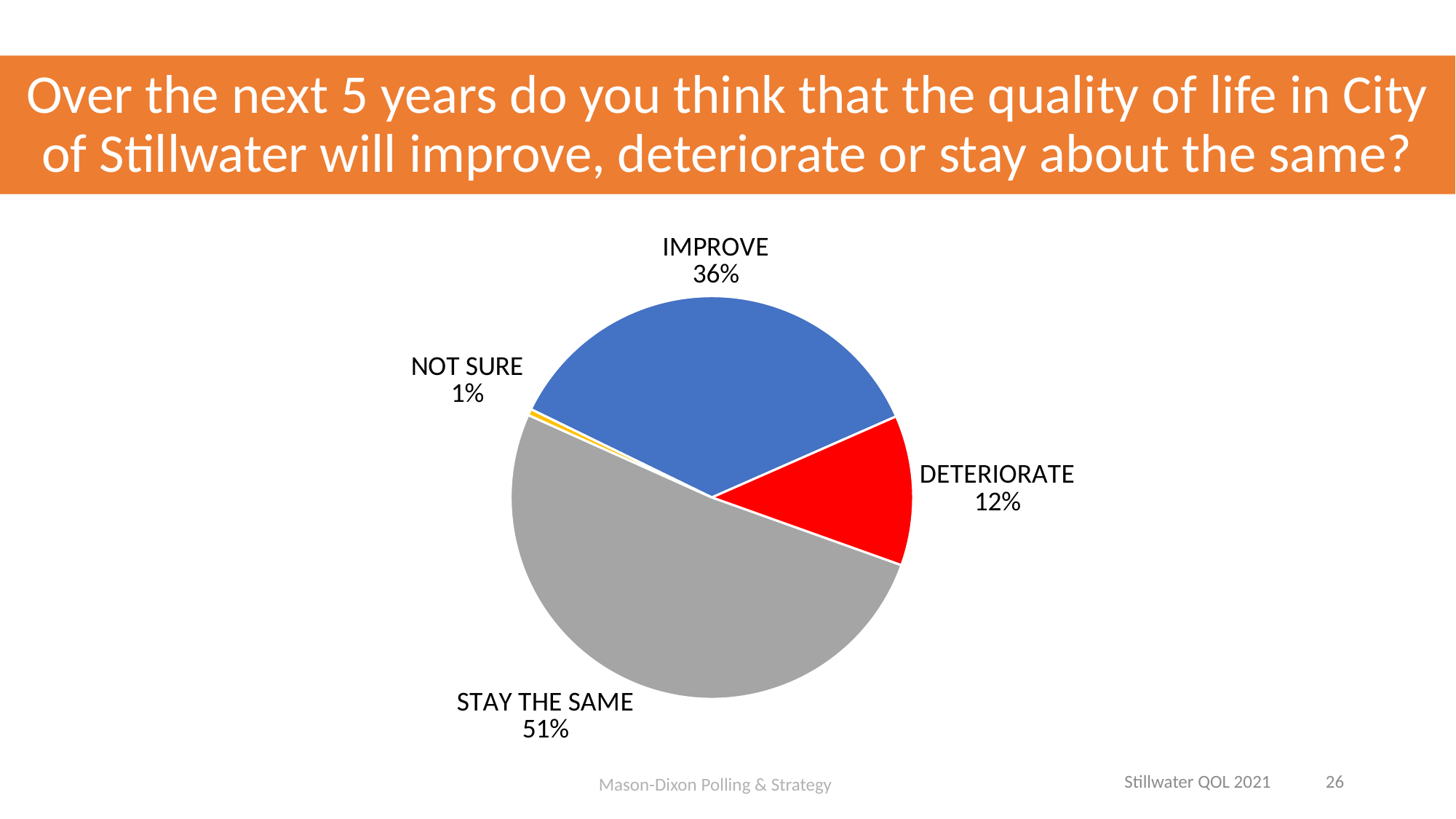
What percentage of respondents were not sure? 1% What is the difference in percentage points between IMPROVE and DETERIORATE? 24 What kind of chart is shown on the slide? Pie chart What percentage of respondents said the quality of life will improve? 36% What colour is the DETERIORATE slice? Red What percentage of respondents said the quality of life will deteriorate? 12% What is the difference in percentage points between STAY THE SAME and IMPROVE? 15 Which response has the smallest share of the pie? NOT SURE What percentage of respondents said the quality of life will stay the same? 51% How many response categories are shown in the pie chart? 4 Which is larger, the share for IMPROVE or the share for DETERIORATE? IMPROVE Which response has the largest share of the pie? STAY THE SAME